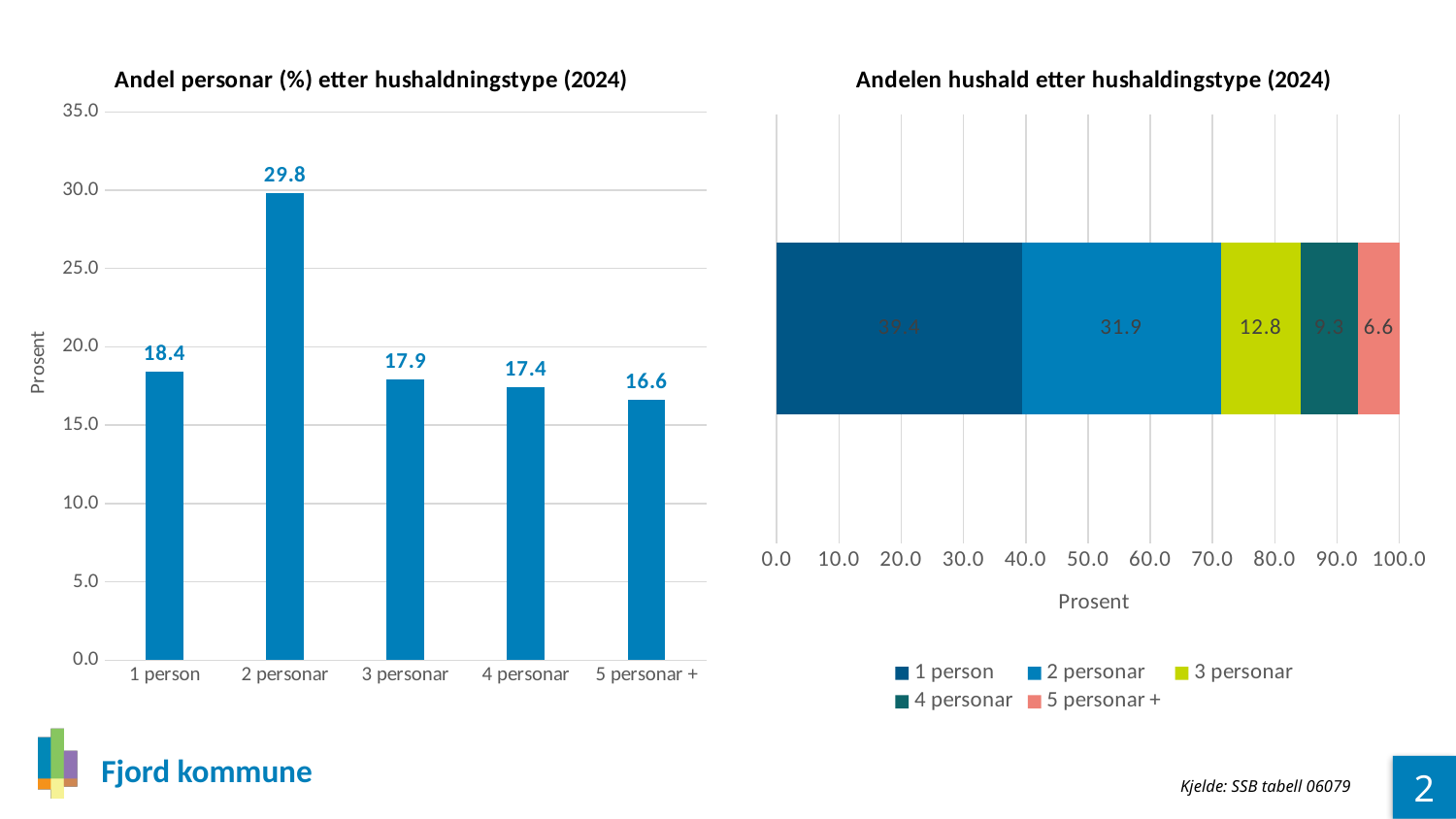
In the left chart 'Andel personar (%) etter hushaldningstype (2024)', what is the difference between the values for 2 personar and 1 person? 11.4 In the left chart 'Andel personar (%) etter hushaldningstype (2024)', which is larger, the value for 3 personar or for 4 personar? 3 personar What kind of chart is the left chart 'Andel personar (%) etter hushaldningstype (2024)'? bar chart How many household type categories are shown in the left chart 'Andel personar (%) etter hushaldningstype (2024)'? 5 In the left chart 'Andel personar (%) etter hushaldningstype (2024)', what is the value for 2 personar? 29.8 In the right chart 'Andelen hushald etter hushaldingstype (2024)', what is the value for 2 personar? 31.9 In the left chart 'Andel personar (%) etter hushaldningstype (2024)', which household type has the lowest value? 5 personar + How many series does the legend of the right chart 'Andelen hushald etter hushaldingstype (2024)' list? 5 In the left chart 'Andel personar (%) etter hushaldningstype (2024)', what is the value for 5 personar +? 16.6 In the right chart 'Andelen hushald etter hushaldingstype (2024)', what is the value for 3 personar? 12.8 In the right chart 'Andelen hushald etter hushaldingstype (2024)', is the value for 1 person greater or less than 30.0? greater In the left chart 'Andel personar (%) etter hushaldningstype (2024)', which household type has the highest value? 2 personar